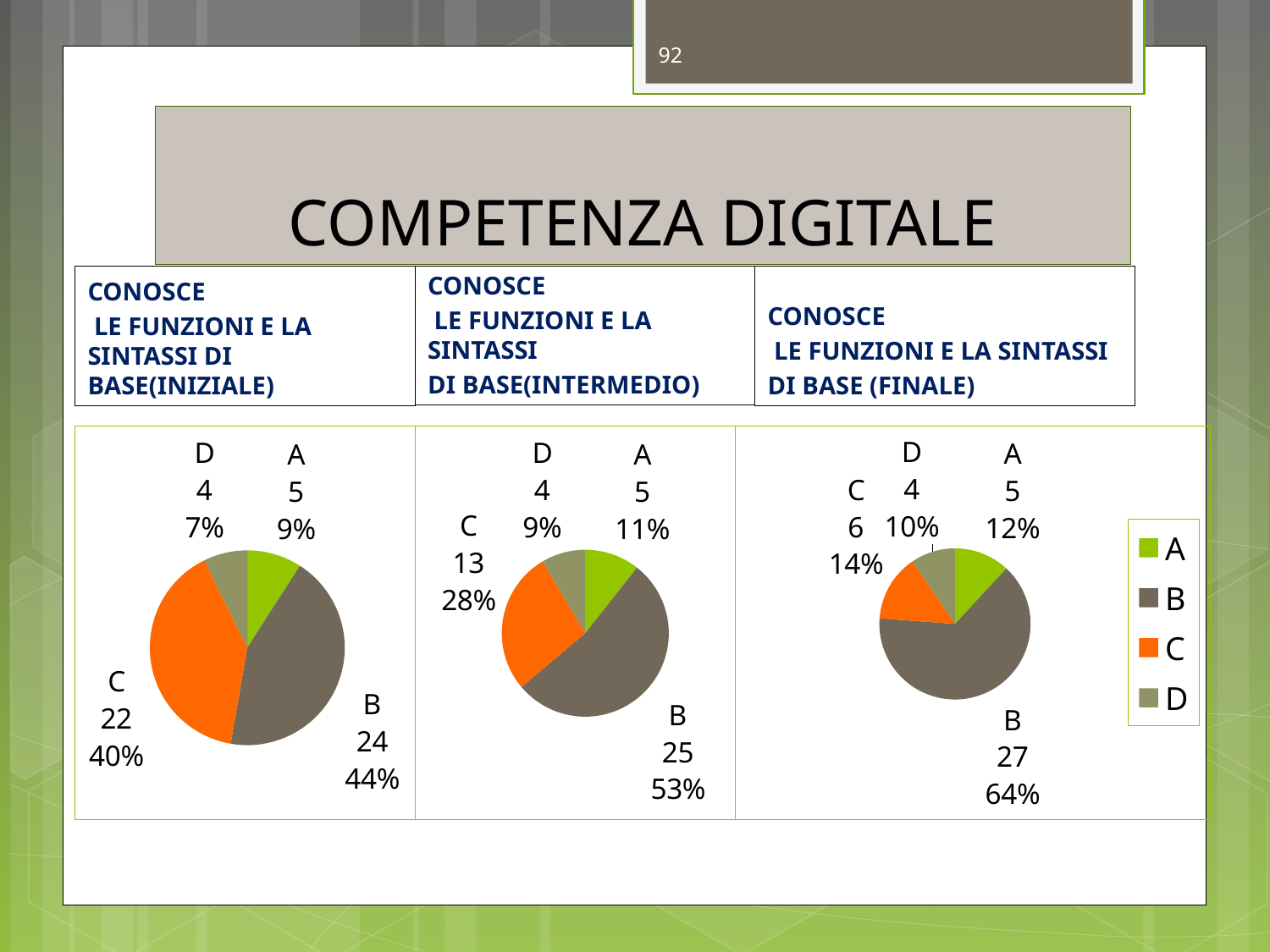
How many categories does each pie chart show? 4 In the left pie chart (INIZIALE), what percentage share does category C have? 40% In the right pie chart (FINALE), what is the count for category B? 27 In the right pie chart (FINALE), what percentage share does category D have? 10% In the left pie chart (INIZIALE), which category has the smallest share? D In the middle pie chart (INTERMEDIO), what is the count for category C? 13 In the right pie chart (FINALE), which category has the largest share? B In the middle pie chart (INTERMEDIO), what is the difference between the counts for B and C? 12 In the left pie chart (INIZIALE), which is larger, the count for B or the count for C? B What type of chart is used on this slide? Pie chart In the middle pie chart (INTERMEDIO), what percentage share does category B have? 53% In the left pie chart (INIZIALE), what is the count for category B? 24